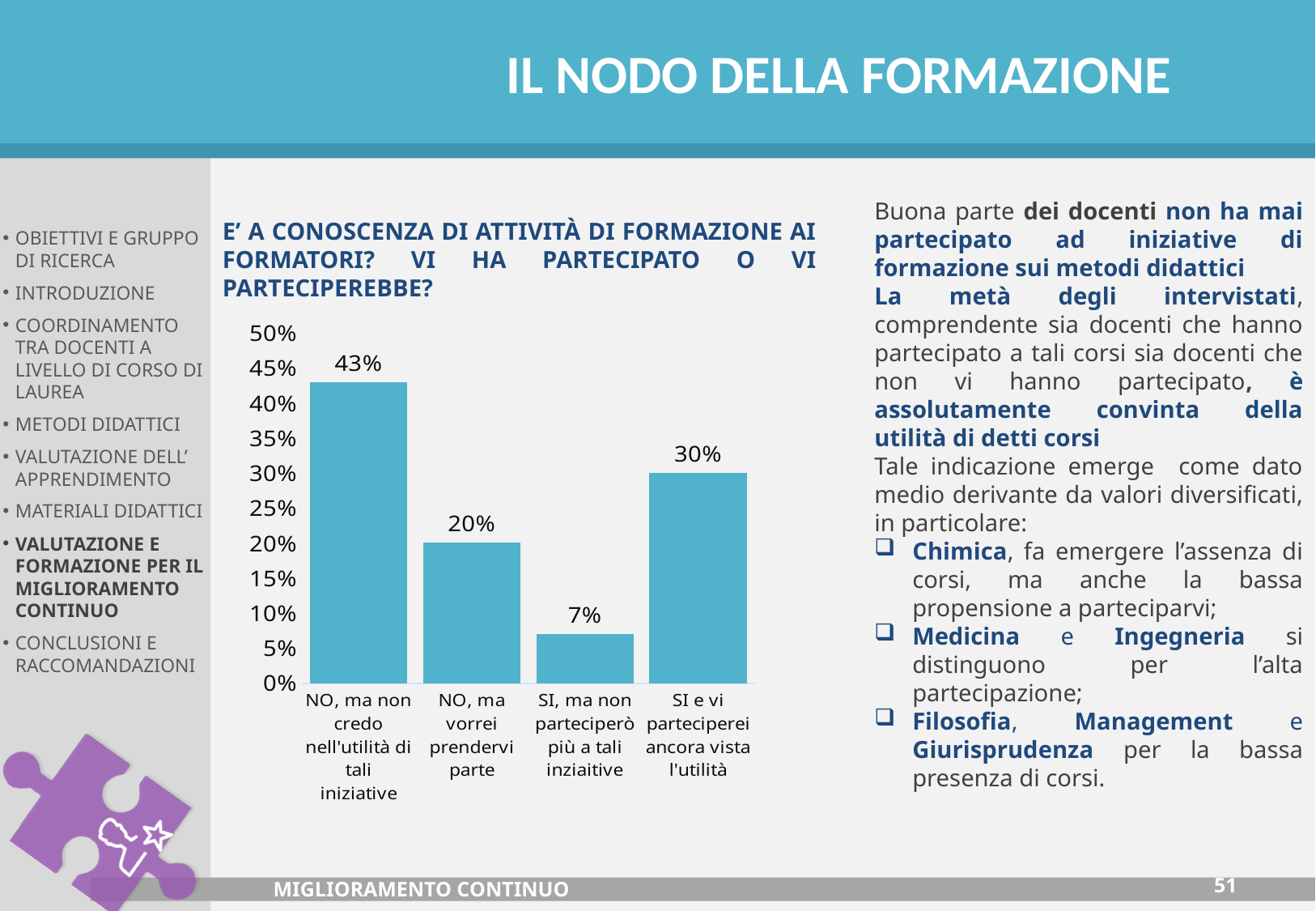
What is the value for "NO, ma non credo nell'utilità di tali iniziative"? 43% Is the value for "NO, ma vorrei prendervi parte" greater or less than 25%? less Which category has the lowest value? SI, ma non parteciperò più a tali iniziative How many categories are shown in the chart? 4 What is the value for "SI e vi parteciperei ancora vista l'utilità"? 30% What is the difference between the values for "NO, ma non credo nell'utilità di tali iniziative" and "SI e vi parteciperei ancora vista l'utilità"? 13% Which category has the highest value? NO, ma non credo nell'utilità di tali iniziative What is the maximum value shown on the vertical axis of the chart? 50% What kind of chart is shown on the slide? bar chart What is the value for "SI, ma non parteciperò più a tali iniziative"? 7% Which is larger: the value for "NO, ma vorrei prendervi parte" or the value for "SI e vi parteciperei ancora vista l'utilità"? SI e vi parteciperei ancora vista l'utilità What is the value for "NO, ma vorrei prendervi parte"? 20%